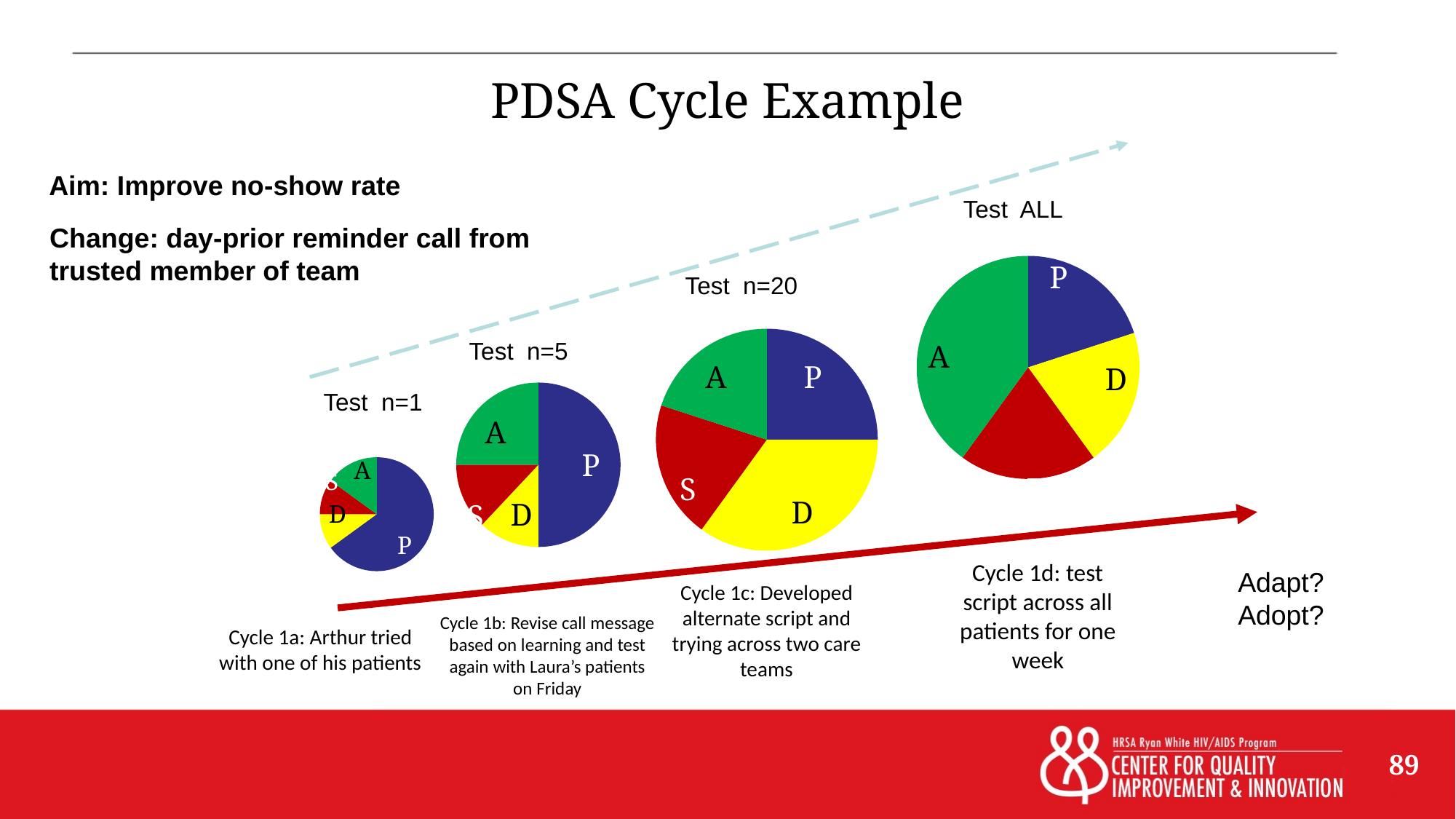
What kind of chart is used for the "Test n=20" cycle on the slide? Pie chart What colour is the A slice in the pie charts on the slide? Green In the "Test ALL" pie chart, which slice is the largest? A In the "Test n=5" pie chart, which slice is the largest? P In the "Test n=20" pie chart, which slice is larger, D or A? D What colour is the P slice in the pie charts on the slide? Blue What is the label above the largest pie chart on the slide? Test ALL In the "Test n=5" pie chart, which slice is larger, P or S? P In the "Test n=1" pie chart, which slice is the largest? P How many pie charts are shown on the slide? 4 In the "Test n=5" pie chart, how many slices are there? 4